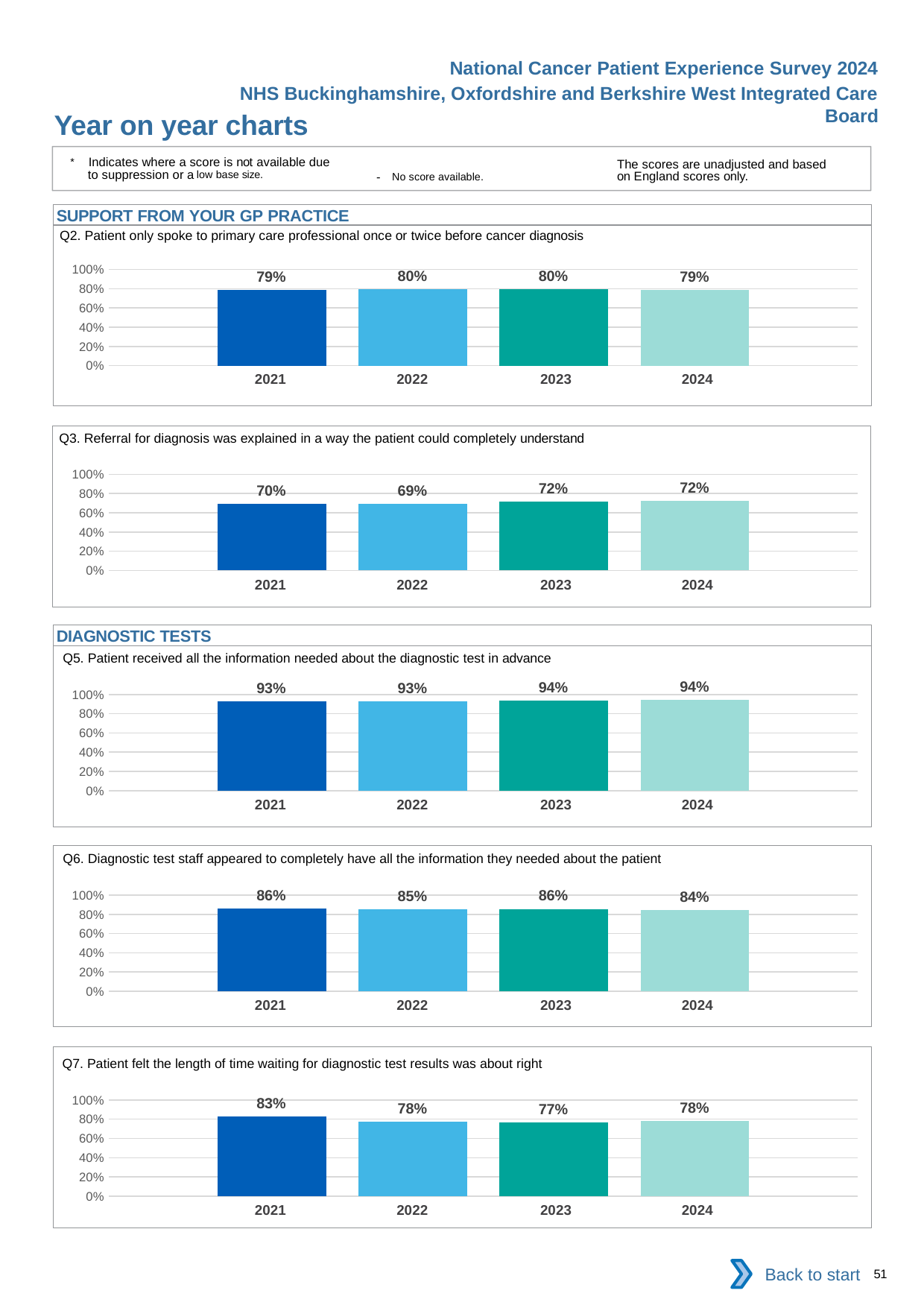
What kind of chart is used for Q2 (patient only spoke to primary care professional once or twice before cancer diagnosis)? Bar chart In the Q7 chart (patient felt the length of time waiting for diagnostic test results was about right), what is the difference between the 2021 value and the 2023 value? 6 percentage points In the Q5 chart (patient received all the information needed about the diagnostic test in advance), what is the value for 2024? 94% In the Q5 chart (patient received all the information needed about the diagnostic test in advance), how many years are shown on the x axis? 4 How many charts are shown on the slide? 5 In the Q3 chart (referral for diagnosis was explained in a way the patient could completely understand), what is the difference between the 2024 value and the 2021 value? 2 percentage points In the Q7 chart (patient felt the length of time waiting for diagnostic test results was about right), which year has the highest value? 2021 In the Q6 chart (diagnostic test staff appeared to completely have all the information they needed about the patient), what is the value for 2022? 85% In the Q7 chart (patient felt the length of time waiting for diagnostic test results was about right), is the value for 2021 larger or the value for 2022? 2021 In the Q2 chart (patient only spoke to primary care professional once or twice before cancer diagnosis), what is the value for 2022? 80% In the Q6 chart (diagnostic test staff appeared to completely have all the information they needed about the patient), which year has the lowest value? 2024 In the Q3 chart (referral for diagnosis was explained in a way the patient could completely understand), which year has the lowest value? 2022